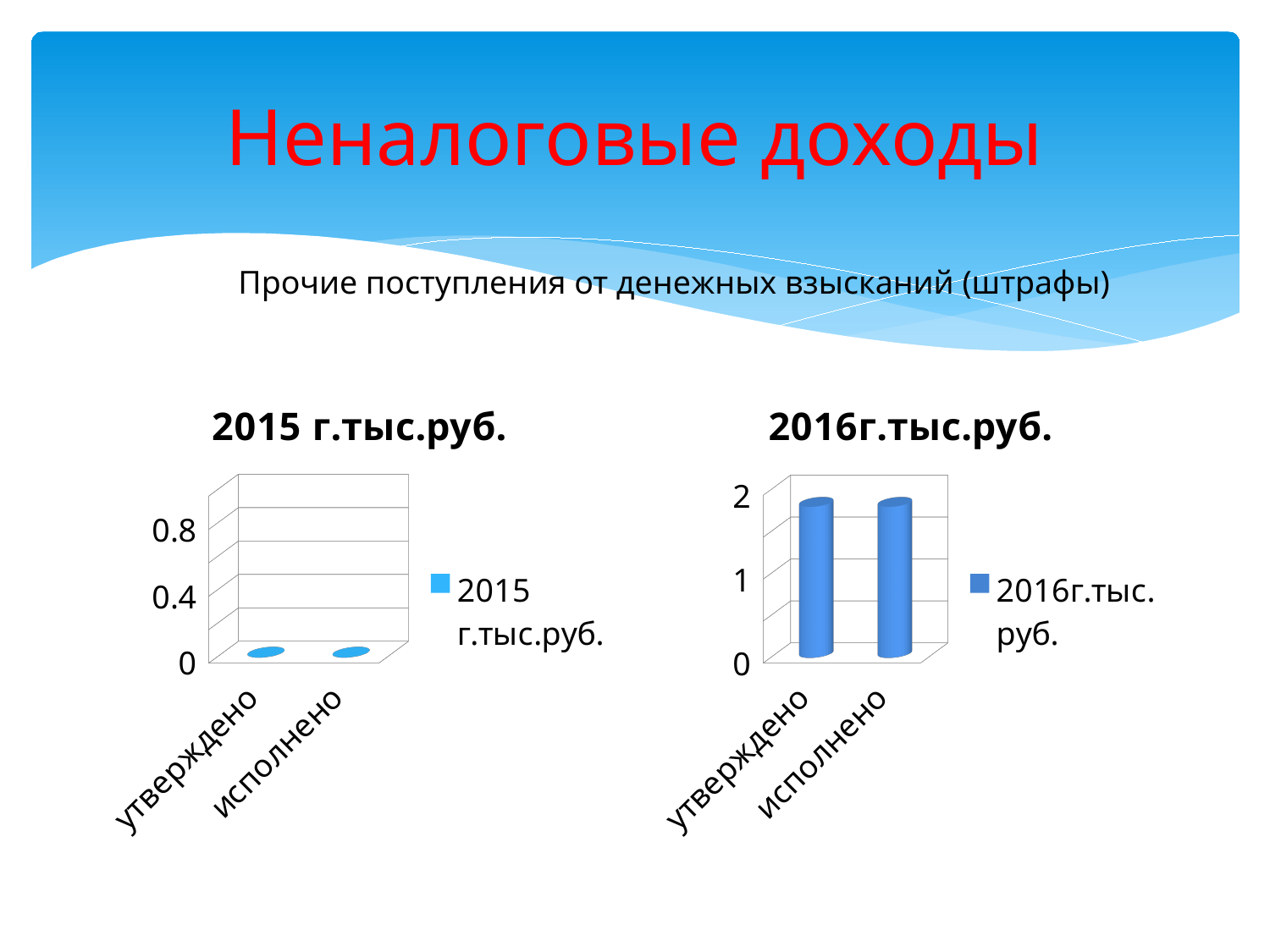
How many series does the legend of the "2015 г.тыс.руб." chart list? 1 In the "2016г.тыс.руб." chart, is the value for утверждено greater or less than 1? greater What is the legend entry of the chart on the right of the slide? 2016г.тыс.руб. In the "2016г.тыс.руб." chart, is the value for исполнено greater or less than 1? greater What kind of chart is the "2015 г.тыс.руб." chart? bar chart How many categories are shown on the x axis of the "2016г.тыс.руб." chart? 2 In the "2015 г.тыс.руб." chart, is the value for утверждено greater or less than 0.4? less What is the title of the chart on the left of the slide? 2015 г.тыс.руб. In the "2015 г.тыс.руб." chart, what value does the bar for исполнено land on? 0 What kind of chart is the "2016г.тыс.руб." chart? bar chart What is the highest tick value on the vertical axis of the "2016г.тыс.руб." chart? 2 Which is larger: the value for утверждено in the "2016г.тыс.руб." chart or the value for утверждено in the "2015 г.тыс.руб." chart? 2016г.тыс.руб.